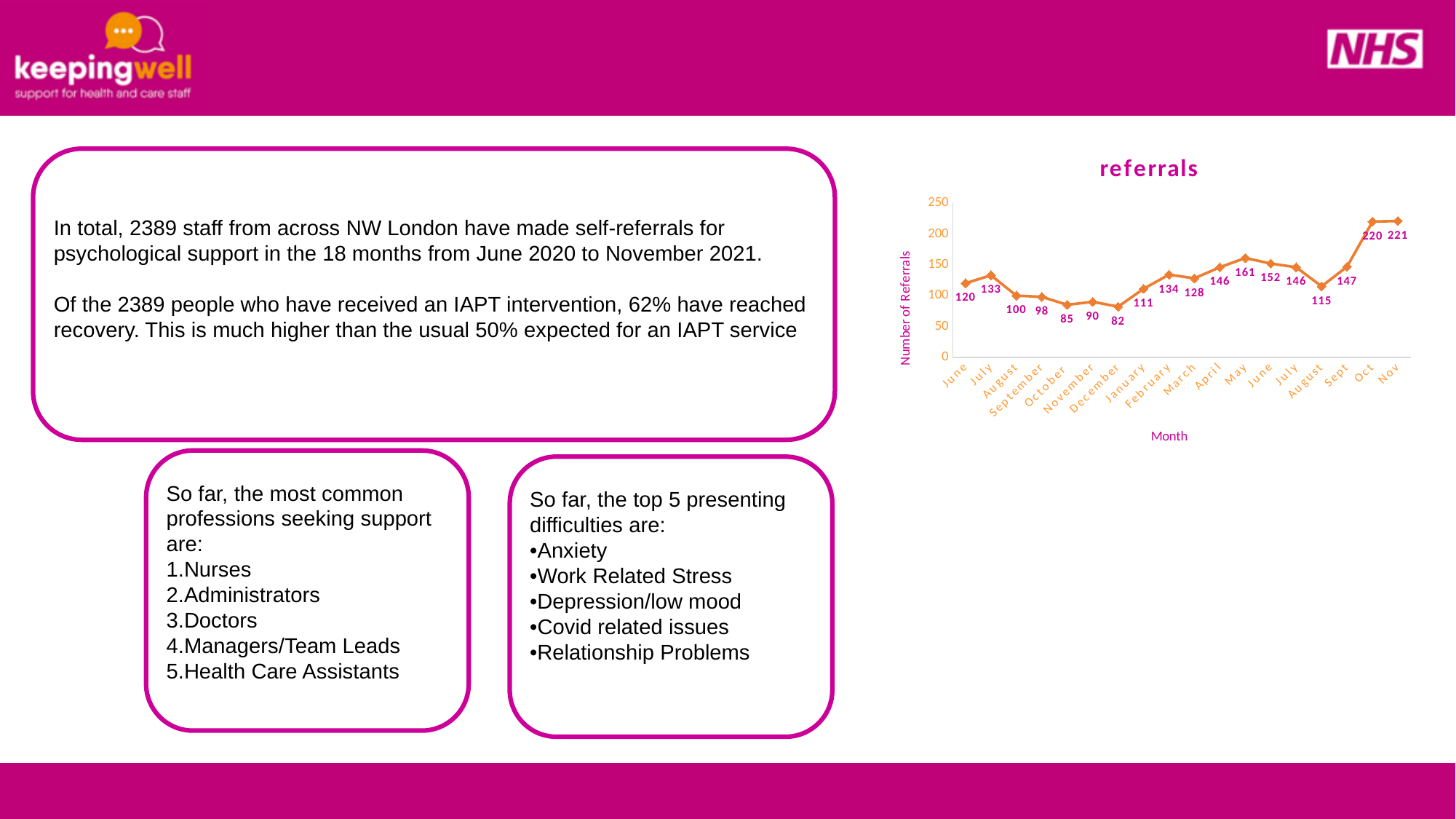
In the 'referrals' chart, what is the number of referrals for May? 161 In the 'referrals' chart, which month has the highest number of referrals? Nov What is the y-axis title of the 'referrals' chart? Number of Referrals In the 'referrals' chart, what is the number of referrals for December? 82 In the 'referrals' chart, which is larger, the value for January or the value for February? February In the 'referrals' chart, do the values rise or fall from Sept to Nov? rise In the 'referrals' chart, what is the value of the first point, labelled June? 120 What kind of chart is the 'referrals' chart? line chart In the 'referrals' chart, what is the difference between the values for Oct and Sept? 73 In the 'referrals' chart, is the value for March greater or less than 150? less How many data points are plotted in the 'referrals' chart? 18 In the 'referrals' chart, which month has the lowest number of referrals? December